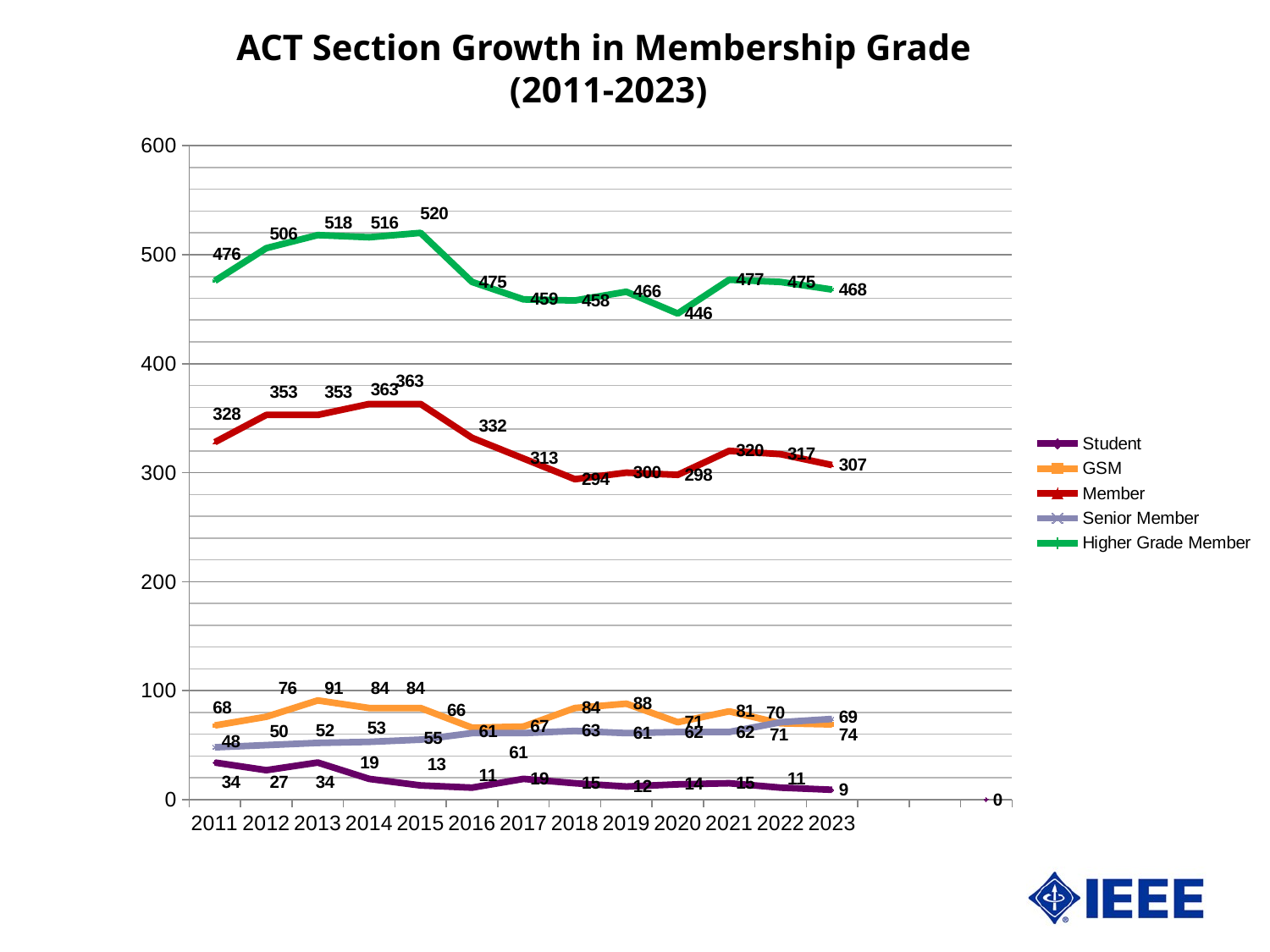
What is the Member value for 2018? 294 How many years are shown on the x axis with data labels? 13 In which year is the Higher Grade Member value lowest? 2020 What is the Higher Grade Member value for 2015? 520 Does the Student series generally rise or fall from 2011 to 2023? fall What is the Student value for 2023? 9 In which year is the GSM value highest? 2013 What is the difference between the Member values for 2015 and 2023? 56 Which is larger in 2022: the Senior Member value or the GSM value? Senior Member What is the title of the chart? ACT Section Growth in Membership Grade (2011-2023) What type of chart is shown on the slide? line chart How many series does the legend list? 5